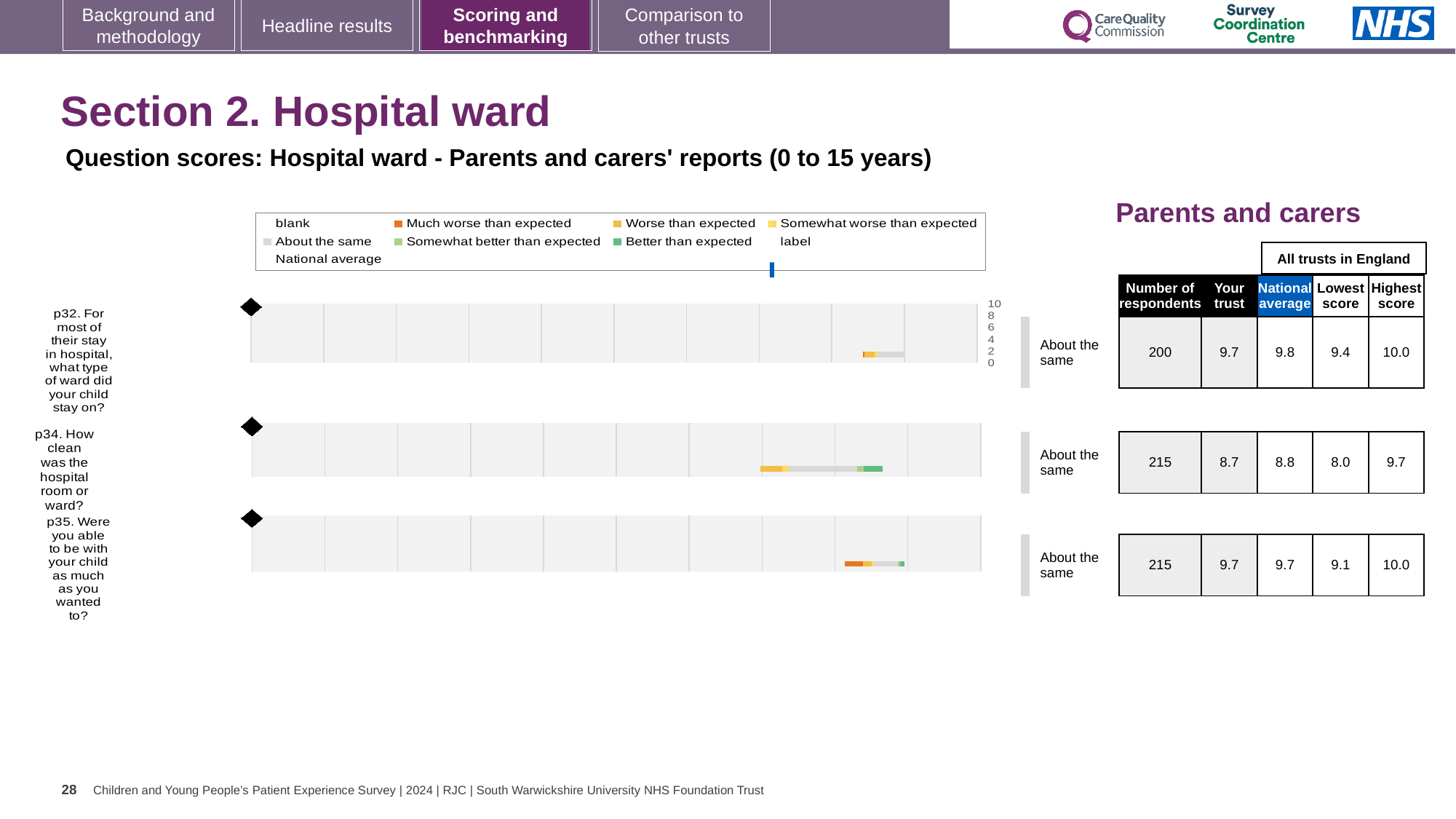
What colour does the legend use for 'Better than expected'? green How many questions are plotted in the chart? 3 What is the 'Your trust' score for p34 (How clean was the hospital room or ward?)? 8.7 What is the difference between the highest score and the lowest score for p34? 1.7 What is the highest score among all trusts in England for p35? 10.0 For p32, which is larger: the 'Your trust' score or the national average? National average What is the national average score for p34? 8.8 What kind of chart is used to show the question scores on this slide? bar chart What is the lowest score among all trusts in England for p32? 9.4 How many respondents are listed for p32 (what type of ward did your child stay on)? 200 Which question has the lowest 'Your trust' score? p34 What benchmark category is shown next to the bar for p35? About the same